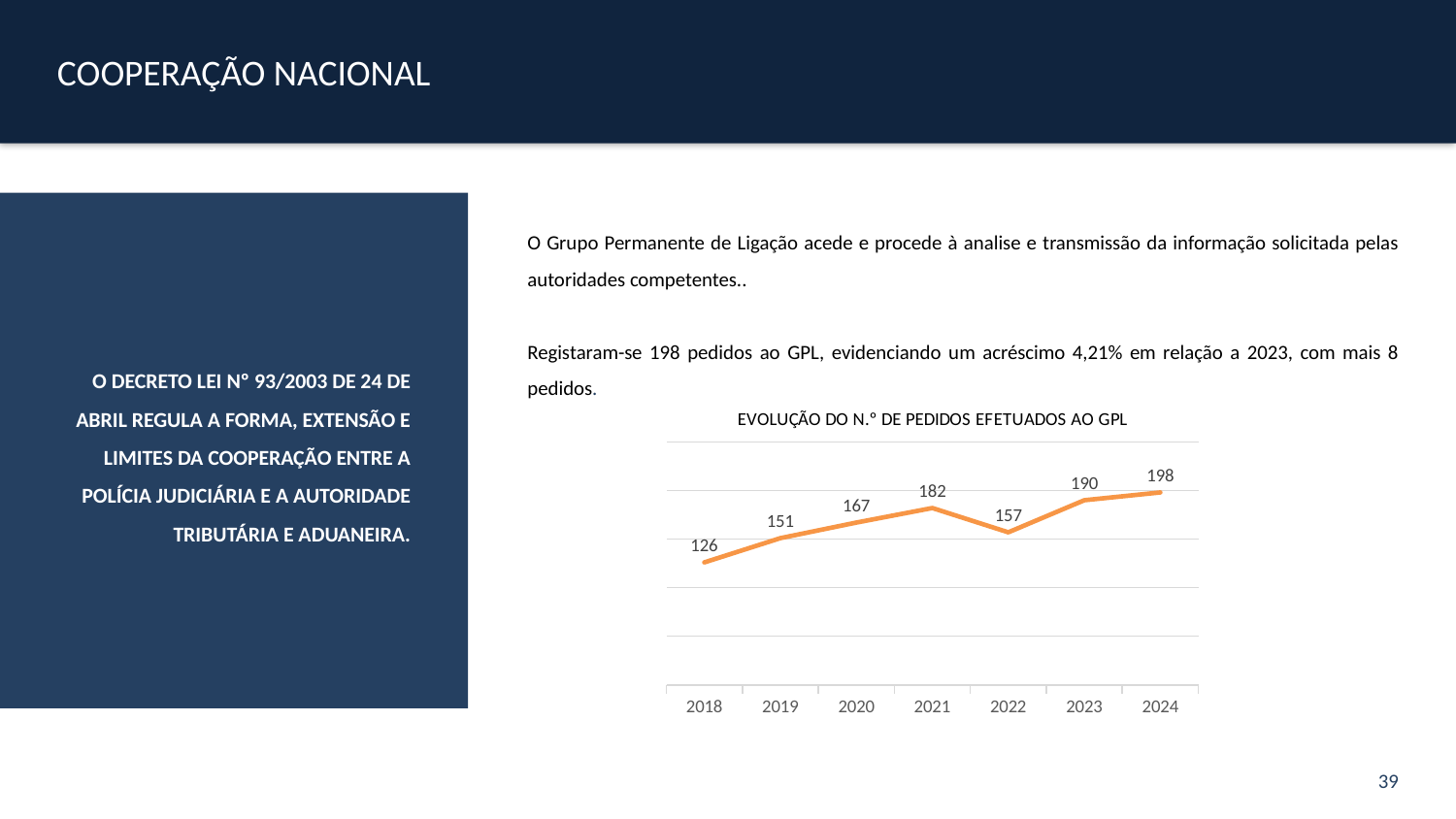
What is the value for 2024? 198 What is the value for 2018? 126 What is the difference between the values for 2024 and 2023? 8 How many years are plotted on the x axis? 7 What is the title of the chart? EVOLUÇÃO DO N.º DE PEDIDOS EFETUADOS AO GPL Which year has the lowest value? 2018 Which year has the highest value? 2024 What is the difference between the values for 2021 and 2022? 25 Which is larger, the value for 2021 or the value for 2022? 2021 What is the value for 2022? 157 Does the value rise or fall from 2018 to 2021? Rise What type of chart is shown on the slide? Line chart